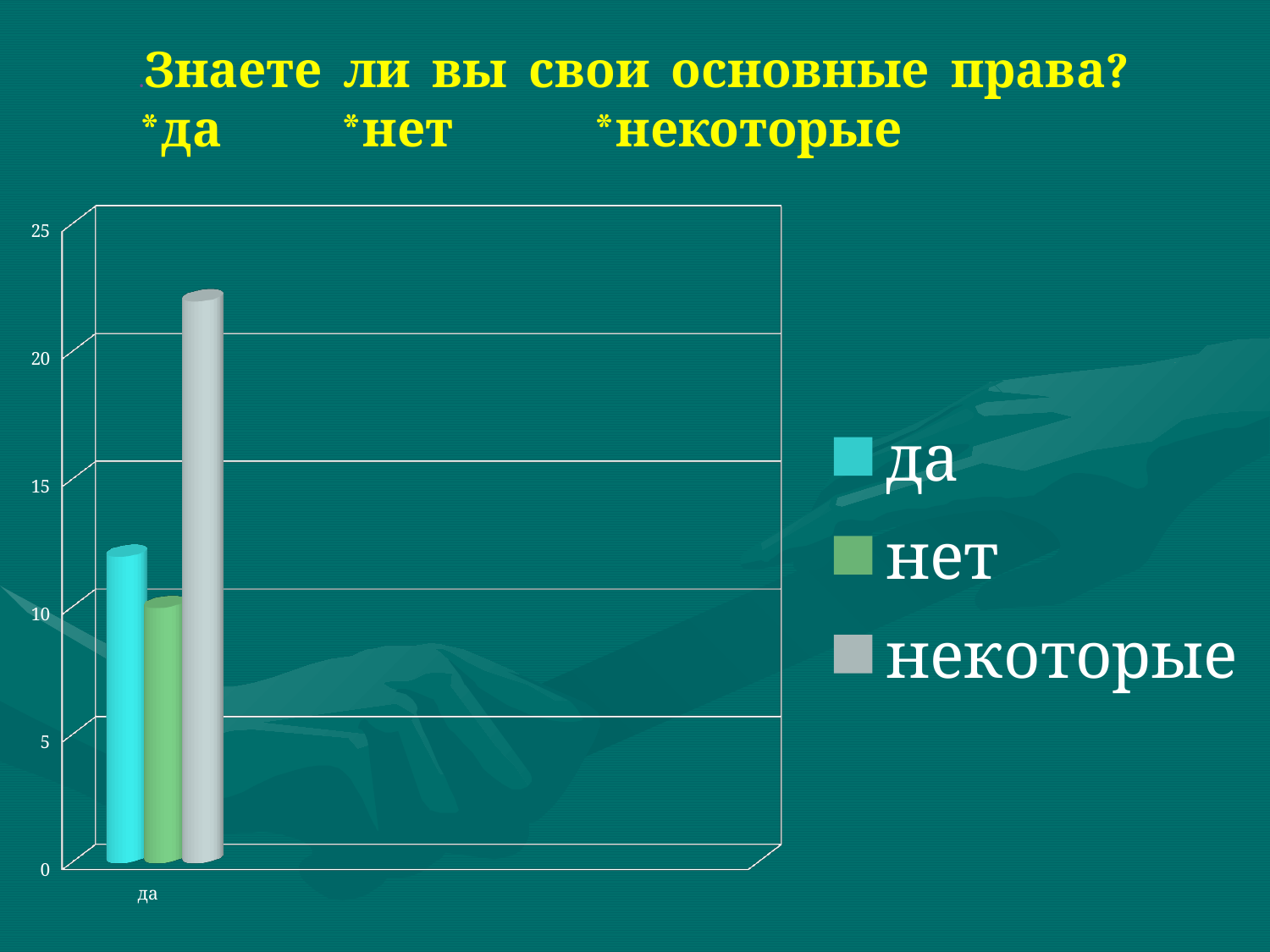
What question is asked in the slide title above the chart? Знаете ли вы свои основные права? How many series does the legend list? 3 What kind of chart is shown on the slide? bar chart Is the value for некоторые greater or less than 20? greater Is the value for да greater or less than 15? less Which series has the shortest bar? нет What colour is the bar for некоторые in the legend? grey Which series has the tallest bar? некоторые Is the value for нет greater or less than 15? less Which is larger, the bar for некоторые or the bar for да? некоторые Which is larger, the bar for да or the bar for нет? да